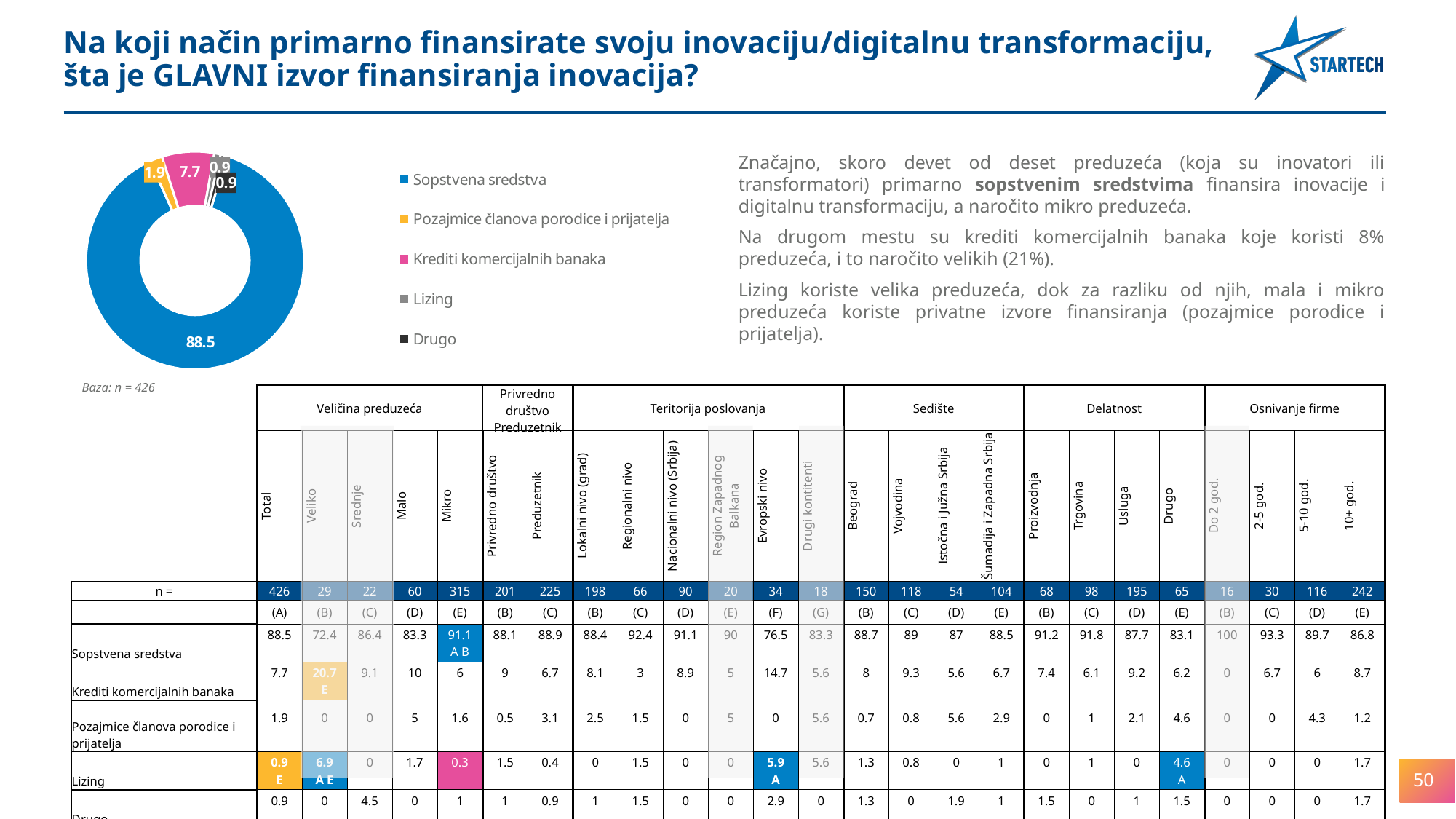
Which category has the largest share in the donut chart? Sopstvena sredstva What is the value for Lizing in the donut chart? 0.9 How many categories does the donut chart show? 5 What is the value for Sopstvena sredstva in the donut chart? 88.5 What is the value for Pozajmice članova porodice i prijatelja in the donut chart? 1.9 How many entries does the legend of the donut chart list? 5 Which is larger in the donut chart, Krediti komercijalnih banaka or Pozajmice članova porodice i prijatelja? Krediti komercijalnih banaka What is the value for Krediti komercijalnih banaka in the donut chart? 7.7 What kind of chart is shown on the slide? Donut (pie) chart What is the base (n) stated below the donut chart? n = 426 What is the difference between the values for Sopstvena sredstva and Krediti komercijalnih banaka in the donut chart? 80.8 What is the difference between the values for Krediti komercijalnih banaka and Pozajmice članova porodice i prijatelja in the donut chart? 5.8